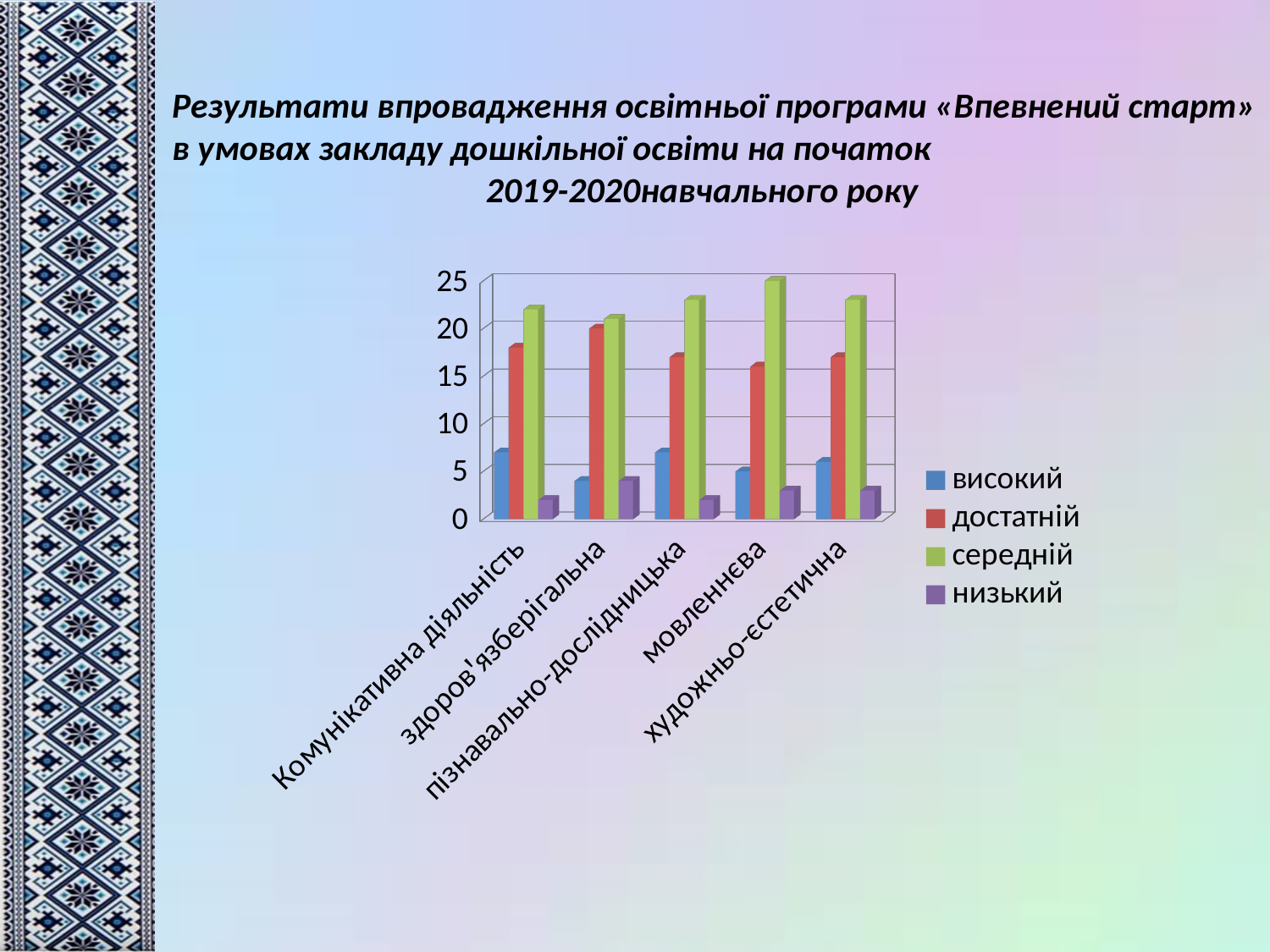
Is the 'достатній' value for 'Комунікативна діяльність' greater or less than 15? greater Is the 'низький' value for 'пізнавально-дослідницька' greater or less than 5? less How many categories are shown along the x axis of the chart? 5 How many series does the chart legend list? 4 What kind of chart is shown on the slide? bar chart Which series is shown in blue in the chart legend? високий For which category is the 'середній' value the highest? мовленнєва Is the 'середній' value for 'мовленнєва' greater or less than 20? greater Which colour represents the 'середній' series in the chart? green Which is larger for 'здоров'язберігальна': the 'достатній' value or the 'високий' value? достатній